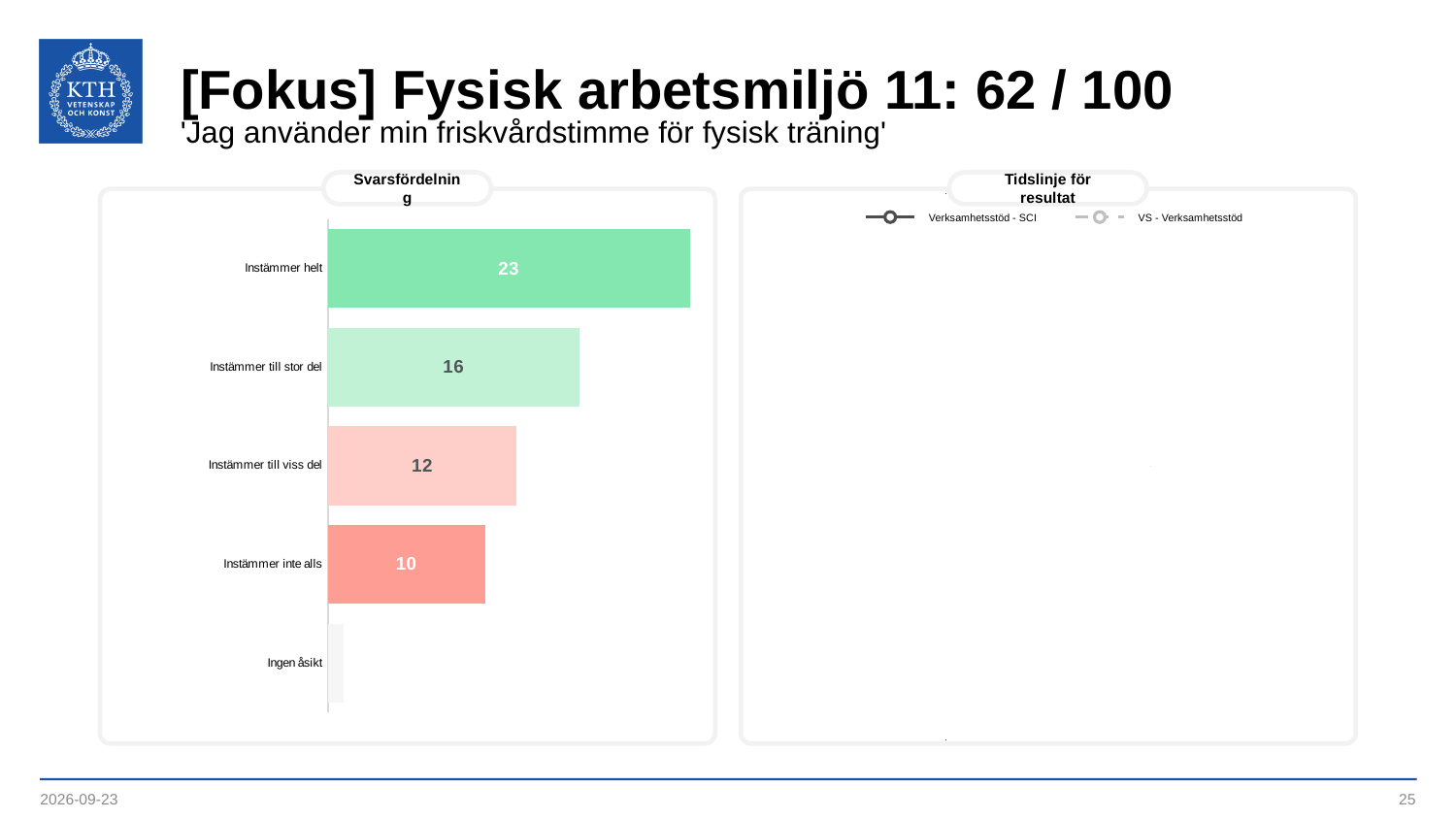
In the 'Svarsfördelning' chart, which category has the highest value? Instämmer helt In the 'Svarsfördelning' chart, what is the difference between 'Instämmer till stor del' and 'Instämmer till viss del'? 4 How many categories are shown in the 'Svarsfördelning' chart? 5 In the 'Svarsfördelning' chart, what is the value for 'Instämmer inte alls'? 10 In the 'Svarsfördelning' chart, which is larger: 'Instämmer till viss del' or 'Instämmer inte alls'? Instämmer till viss del In the 'Svarsfördelning' chart, which category has the lowest value? Ingen åsikt In the 'Svarsfördelning' chart, what is the difference between 'Instämmer helt' and 'Instämmer inte alls'? 13 In the 'Svarsfördelning' chart, what is the value for 'Instämmer till viss del'? 12 How many series does the legend of the 'Tidslinje för resultat' chart list? 2 In the 'Svarsfördelning' chart, what is the value for 'Instämmer helt'? 23 In the 'Svarsfördelning' chart, what is the value for 'Instämmer till stor del'? 16 What kind of chart is the 'Svarsfördelning' chart? Bar chart